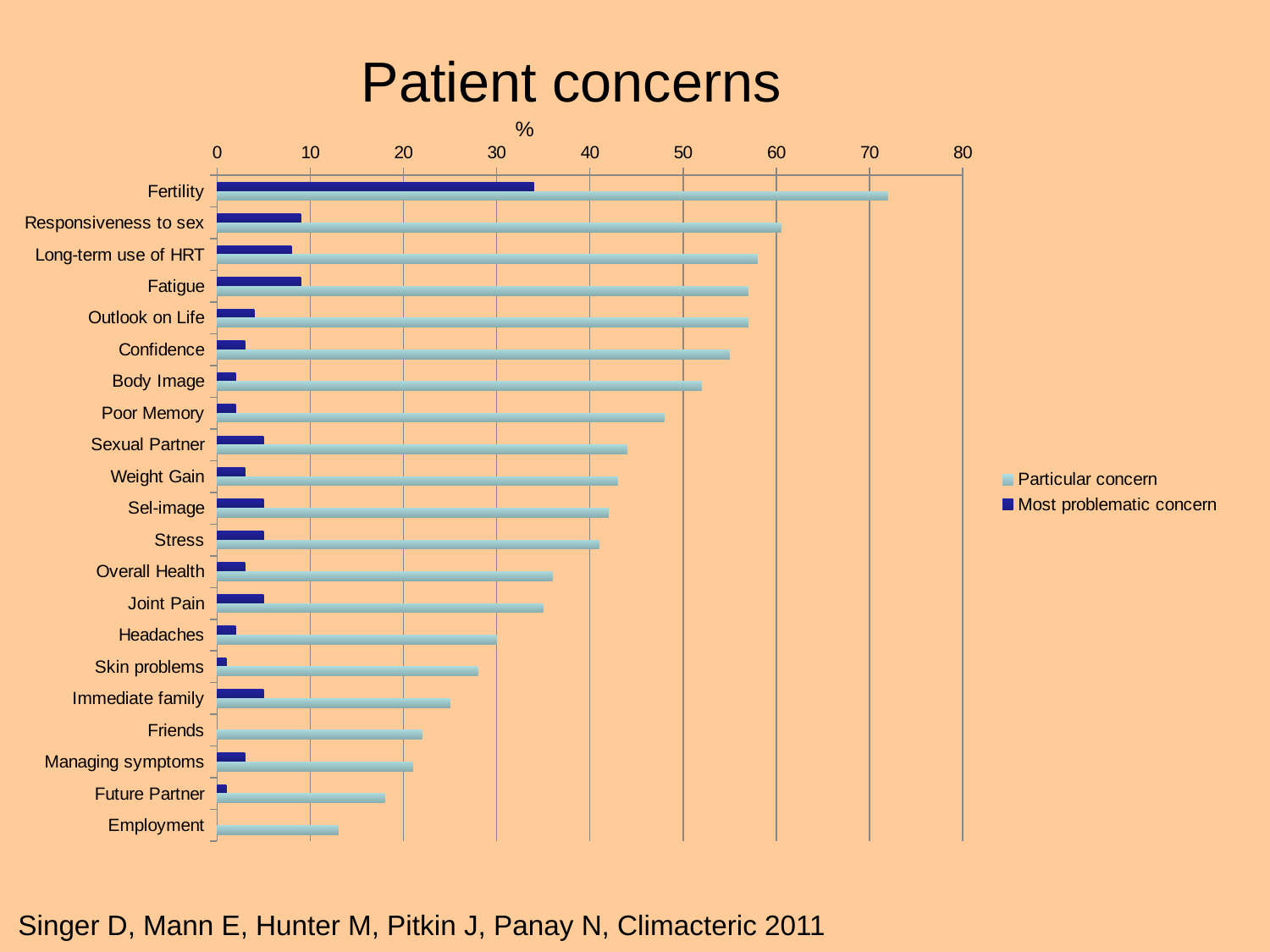
Which category has the highest value for Most problematic concern? Fertility What is the title of the chart? Patient concerns Is the Most problematic concern value for Fertility greater or less than 30? greater How many series does the legend list? 2 Which category has the highest value for Particular concern? Fertility Is the Particular concern value for Long-term use of HRT greater or less than 60? less Which is larger, the Most problematic concern value for Fertility or for Responsiveness to sex? Fertility Is the Particular concern value for Future Partner greater or less than 20? less Which category has the lowest value for Particular concern? Employment What kind of chart is shown on the slide? bar chart How many categories are plotted on the chart? 21